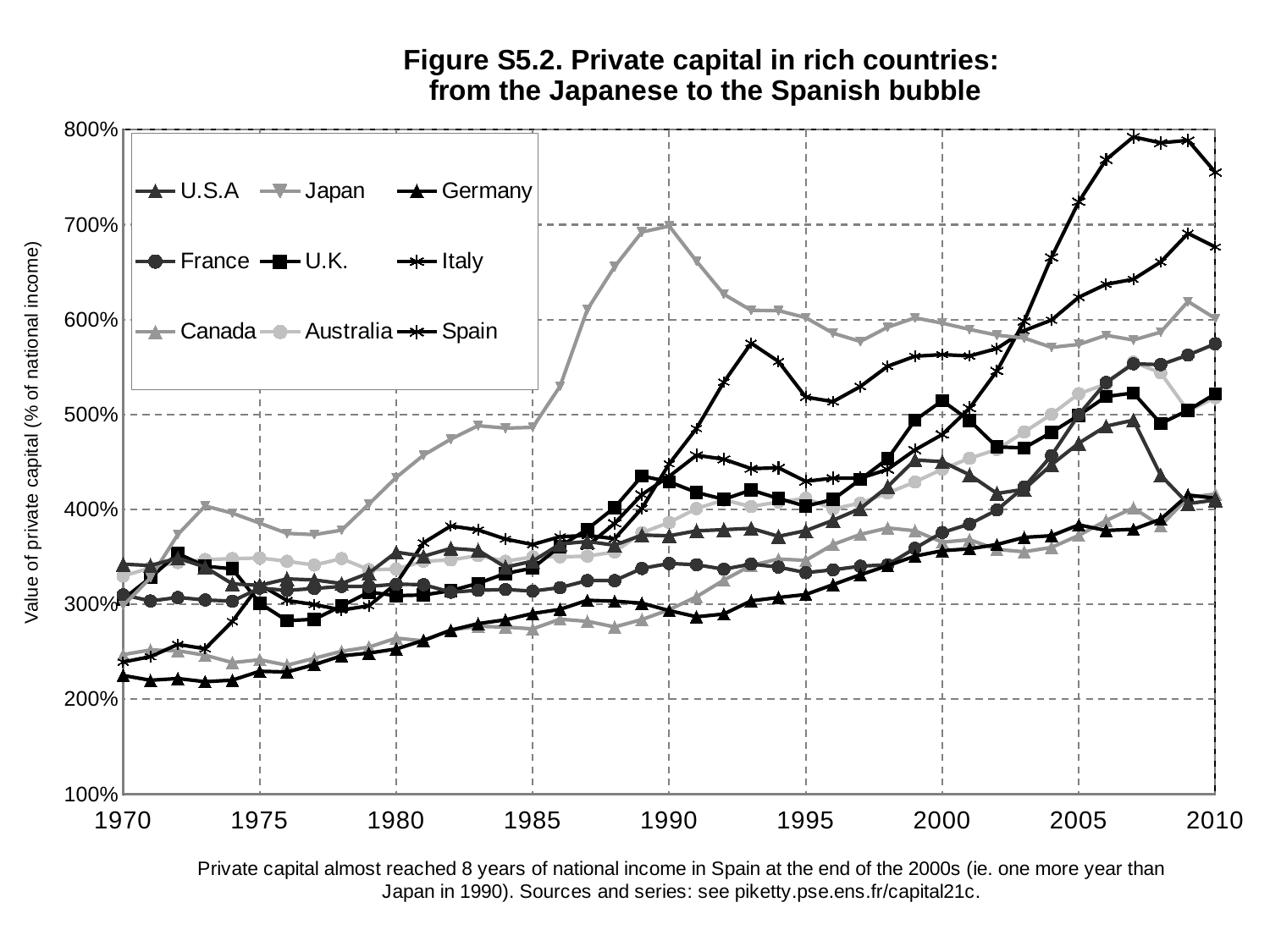
What kind of chart is shown on the slide? line chart Is the value for Germany in 1970 greater or less than 300%? less Which country has the lowest value of private capital in 1970? Germany What is the label of the vertical axis? Value of private capital (% of national income) Which country has the highest value of private capital in 1990? Japan How many series does the legend list? 9 Which country has the highest value of private capital in 2010? Spain Is the value for Spain in 2007 greater or less than 700%? greater Is the value for Italy in 1993 greater or less than 500%? greater What is the title of the chart? Figure S5.2. Private capital in rich countries: from the Japanese to the Spanish bubble In 2000, which is higher: the value for the U.K. or the value for France? U.K. Does the value for Japan rise or fall between 1990 and 1995? fall